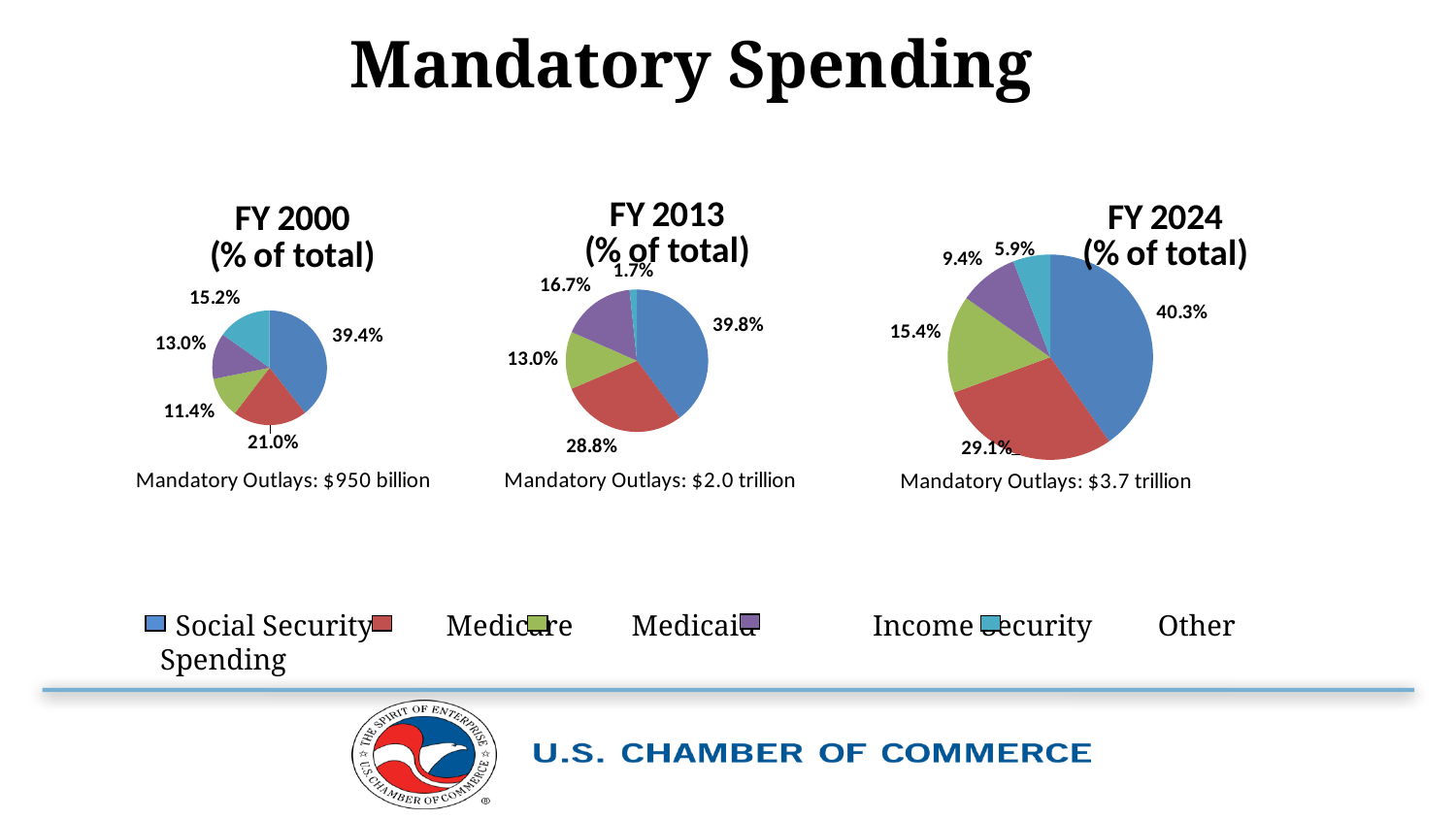
What are the mandatory outlays stated below the FY 2000 (% of total) chart? $950 billion In the FY 2013 (% of total) chart, what share is Medicare? 28.8% In the FY 2024 (% of total) chart, what share is Medicaid? 15.4% What kind of charts are shown on the slide? Pie charts How many categories does the legend list? 5 In the FY 2000 (% of total) chart, what is the difference between the Social Security share and the Medicare share? 18.4% How many pie charts are on the slide? 3 In the FY 2024 (% of total) chart, which category has the largest share? Social Security In the FY 2000 (% of total) chart, what share is Social Security? 39.4% What are the mandatory outlays stated below the FY 2013 (% of total) chart? $2.0 trillion In the FY 2013 (% of total) chart, which category has the smallest share? Other Spending In the FY 2024 (% of total) chart, which is larger, Income Security or Other Spending? Income Security